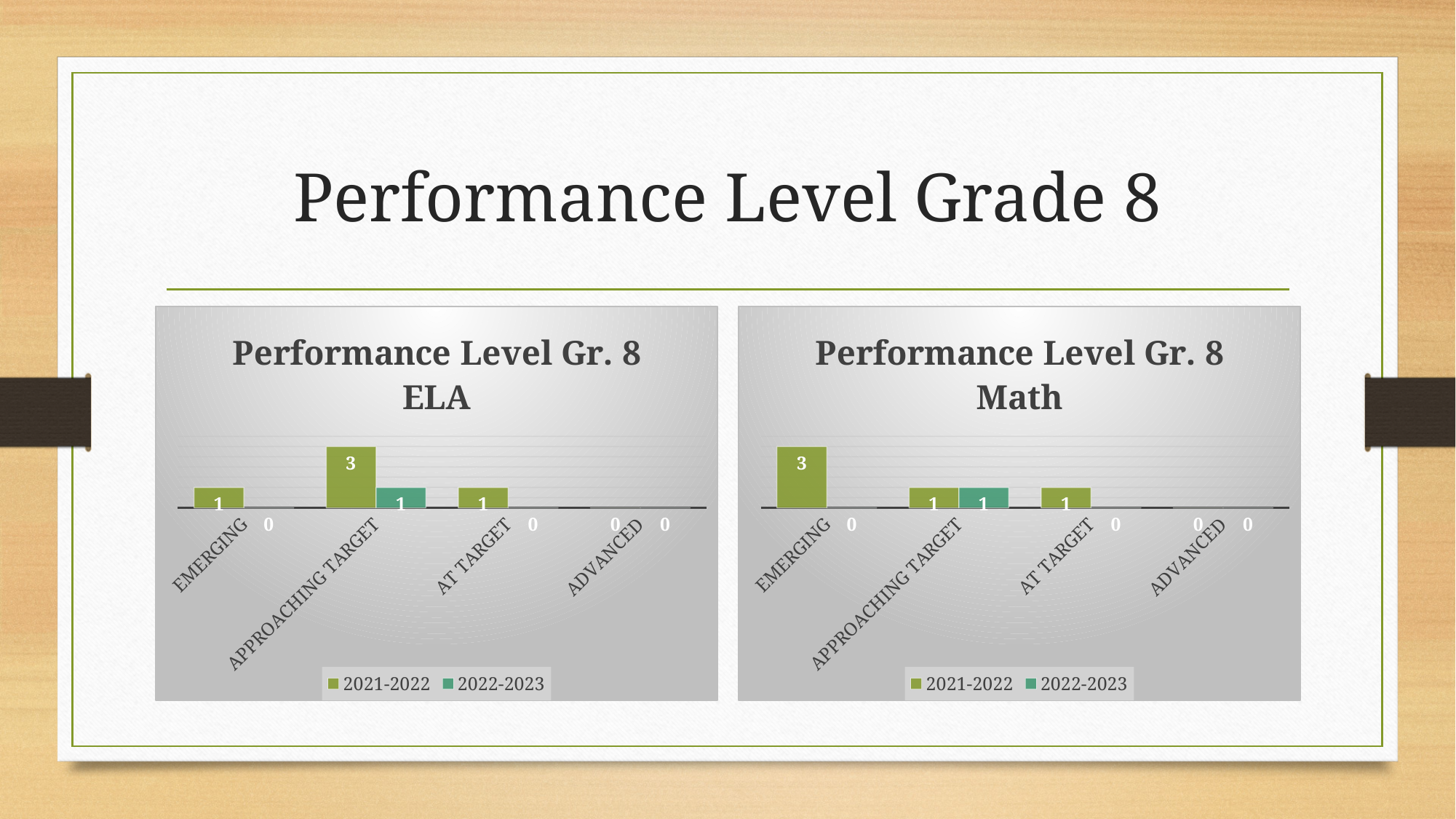
In the Performance Level Gr. 8 ELA chart, which category has the highest 2021-2022 value? Approaching Target How many categories are shown on the x axis of the Performance Level Gr. 8 ELA chart? 4 How many series does the legend of the Performance Level Gr. 8 Math chart list? 2 In the Performance Level Gr. 8 ELA chart, what is the 2021-2022 value for Approaching Target? 3 In the Performance Level Gr. 8 Math chart, what is the 2022-2023 value for At Target? 0 In the Performance Level Gr. 8 ELA chart, what is the difference between the 2021-2022 and 2022-2023 values for Approaching Target? 2 In the Performance Level Gr. 8 Math chart, which is larger for Emerging: the 2021-2022 value or the 2022-2023 value? 2021-2022 What are the two series named in the legend of the Performance Level Gr. 8 ELA chart? 2021-2022 and 2022-2023 In the Performance Level Gr. 8 Math chart, which category has the highest 2021-2022 value? Emerging In the Performance Level Gr. 8 ELA chart, what is the 2022-2023 value for Approaching Target? 1 What kind of chart is the Performance Level Gr. 8 ELA chart? Bar chart In the Performance Level Gr. 8 Math chart, what is the 2021-2022 value for Emerging? 3